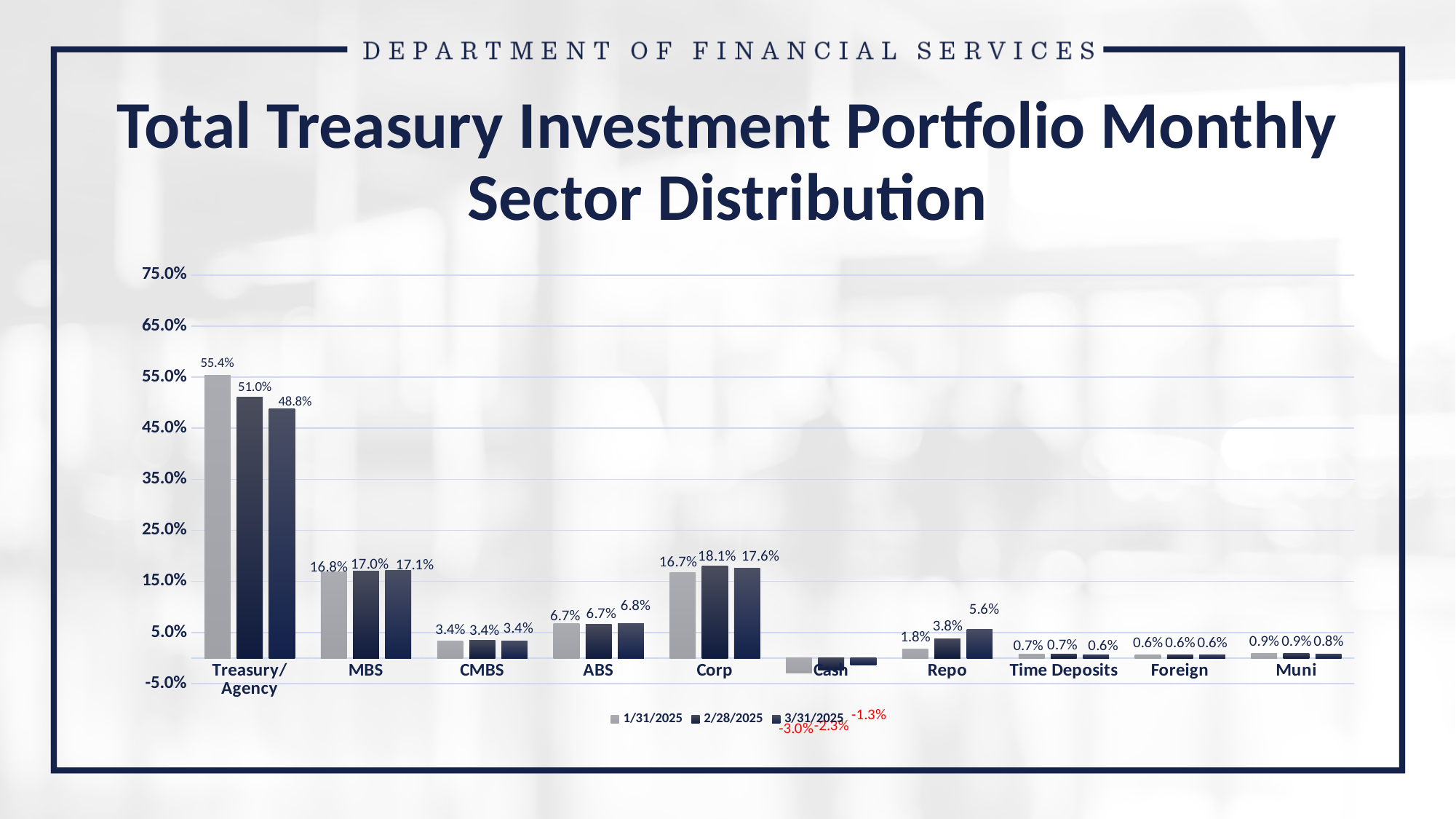
What is the value for Corp on 2/28/2025? 18.1% Which sector has the lowest value on 1/31/2025? Cash Which sector has the highest value on 3/31/2025? Treasury/Agency How many sector categories are shown on the x axis? 10 What is the value for Repo on 3/31/2025? 5.6% What is the title of the chart? Total Treasury Investment Portfolio Monthly Sector Distribution How many series does the legend list? 3 What type of chart is shown on the slide? bar chart Which is larger: the MBS value on 3/31/2025 or the Corp value on 3/31/2025? Corp Do the Treasury/Agency values rise or fall from 1/31/2025 to 3/31/2025? fall What is the difference between the Treasury/Agency values on 1/31/2025 and 3/31/2025? 6.6% What is the value for Treasury/Agency on 1/31/2025? 55.4%